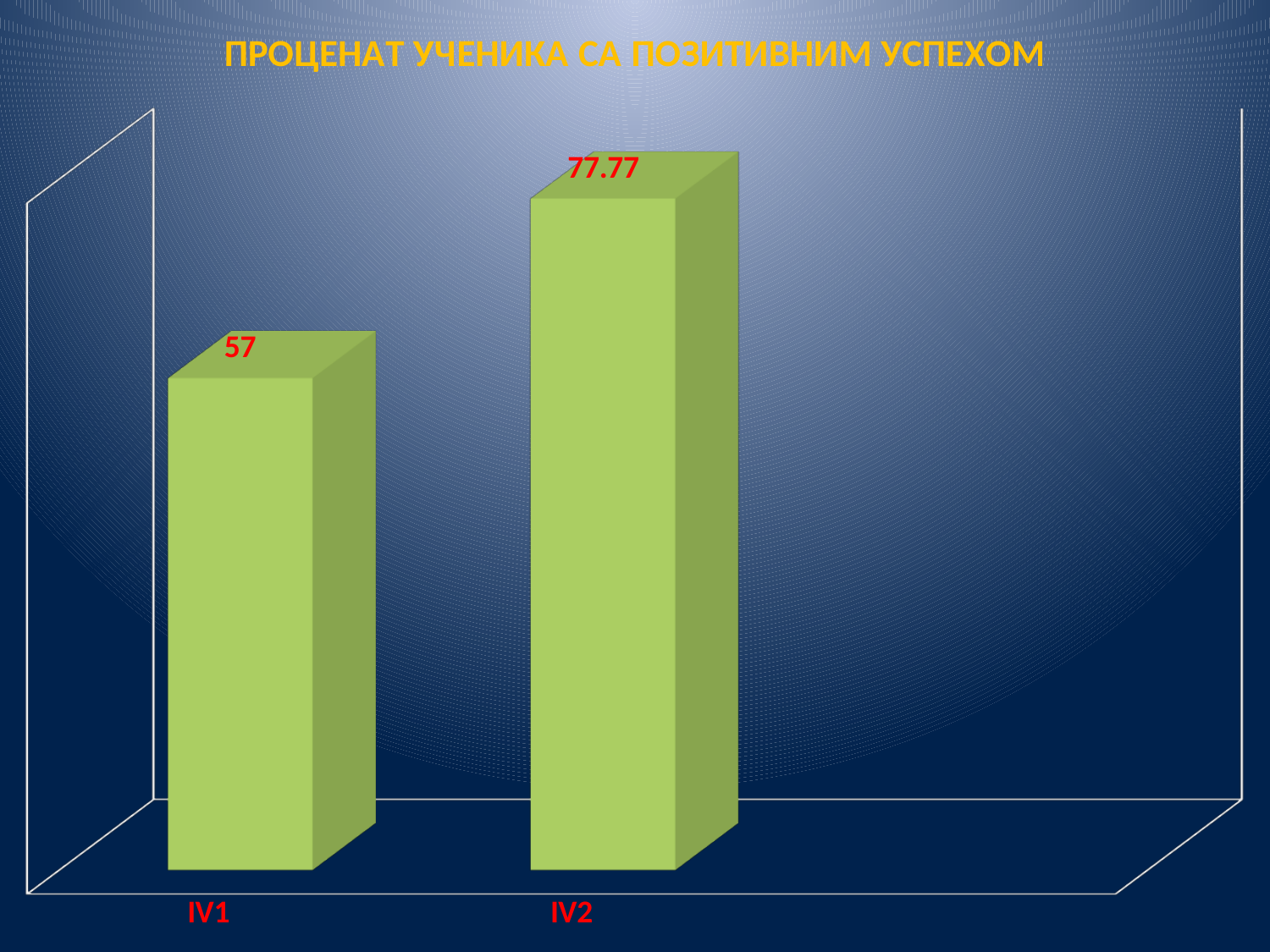
What is the title of the chart? ПРОЦЕНАТ УЧЕНИКА СА ПОЗИТИВНИМ УСПЕХОМ What colour are the bars in the chart? green Do the values rise or fall from IV1 to IV2? rise Which is larger, the value for IV1 or the value for IV2? IV2 What kind of chart is shown on the slide? bar chart What is the value for IV1? 57 How many categories are shown in the chart? 2 Which category has the highest value? IV2 Which category has the lowest value? IV1 What is the difference between the values for IV2 and IV1? 20.77 What is the value for IV2? 77.77